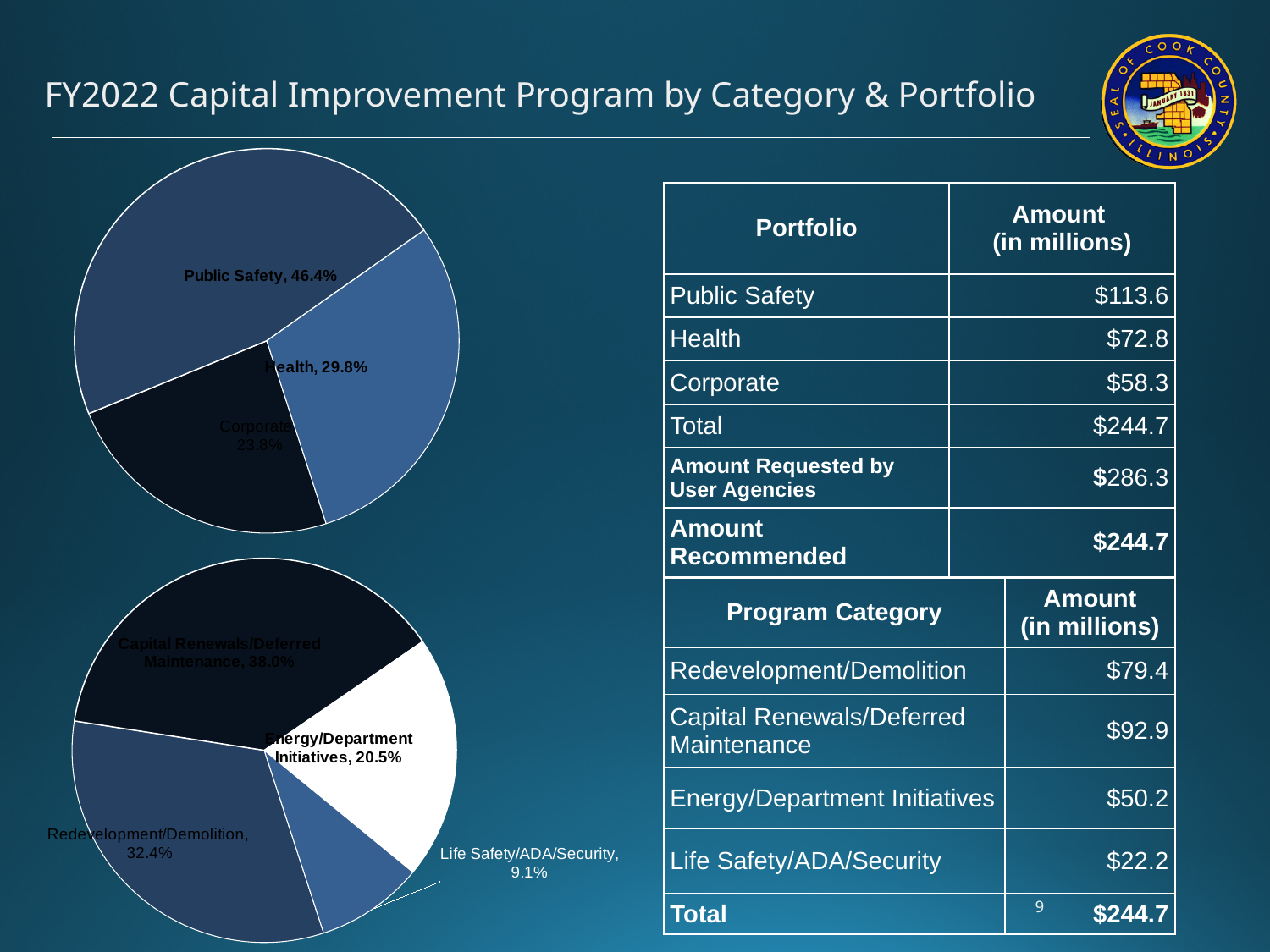
In the top pie chart, which slice is the largest? Public Safety In the top pie chart, what share does Public Safety have? 46.4% What kind of chart is the top chart on the left of the slide? pie chart In the bottom pie chart, what share does Life Safety/ADA/Security have? 9.1% In the bottom pie chart, what share does Capital Renewals/Deferred Maintenance have? 38.0% In the bottom pie chart, which slice is the smallest? Life Safety/ADA/Security In the top pie chart, which slice is the smallest? Corporate In the top pie chart, what share does Health have? 29.8% How many slices does the top pie chart have? 3 In the top pie chart, what is the difference in percentage points between Public Safety and Health? 16.6 How many slices does the bottom pie chart have? 4 In the bottom pie chart, which is larger: Redevelopment/Demolition or Energy/Department Initiatives? Redevelopment/Demolition